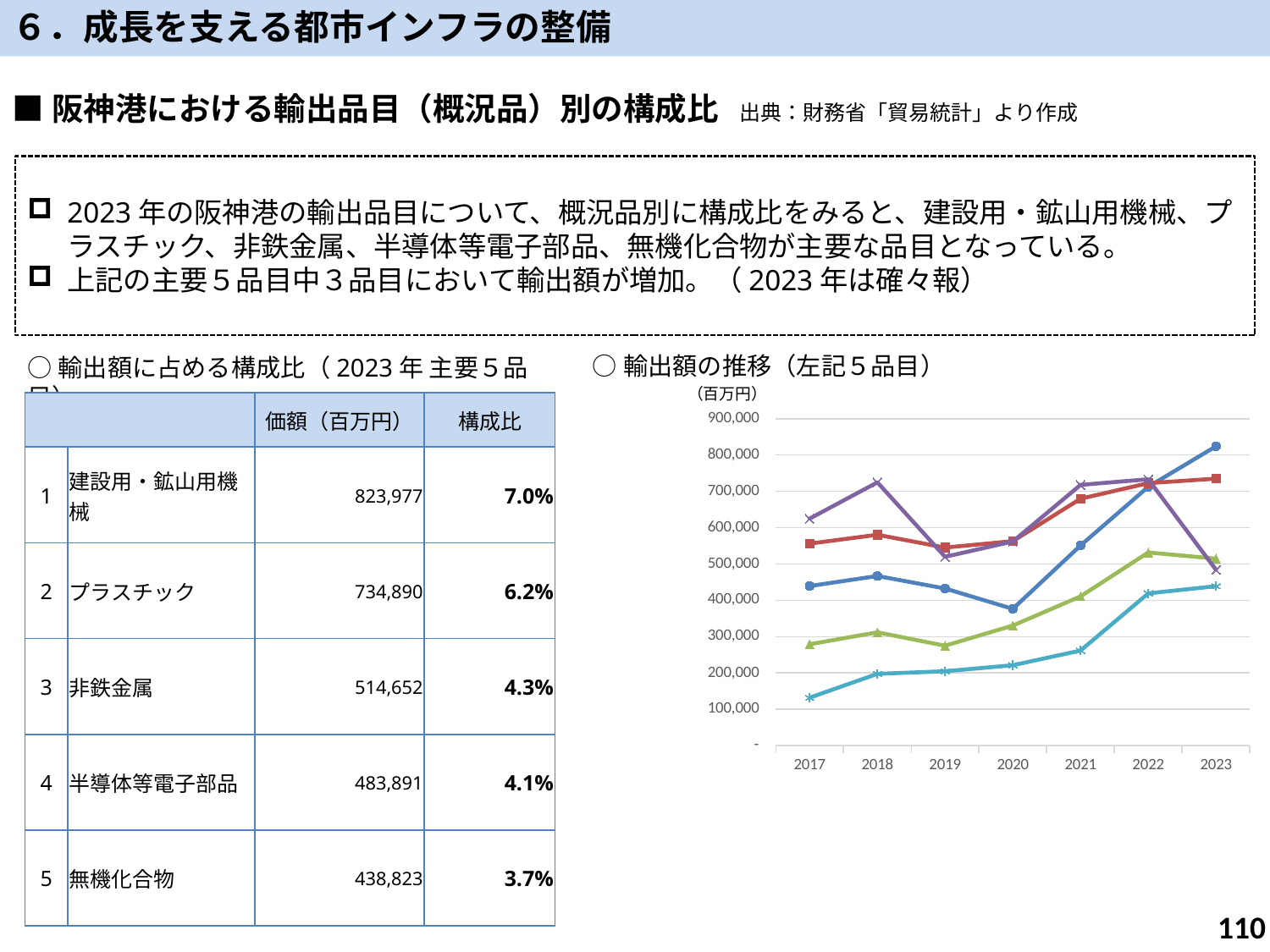
How many years are shown on the x axis of the 輸出額の推移 chart? 7 In the 輸出額の推移 chart, is the 2019 value of the green line with triangle markers greater or less than 300,000? less In the 輸出額の推移 chart, what unit is shown above the y axis? 百万円 In the 輸出額の推移 chart, is the 2023 value of the blue line with circle markers greater or less than 800,000? greater In the 輸出額の推移 chart, what is the first year shown on the x axis? 2017 In the 輸出額の推移 chart, does the light-blue line with asterisk markers rise or fall from 2017 to 2023? rise What kind of chart is shown under 輸出額の推移（左記5品目）? line chart In the 輸出額の推移 chart, is the 2020 value of the blue line with circle markers greater or less than 400,000? less In the 輸出額の推移 chart, in which year does the blue line with circle markers reach its highest value? 2023 In the 輸出額の推移 chart, in which year does the light-blue line with asterisk markers have its lowest value? 2017 How many lines are plotted in the 輸出額の推移 chart? 5